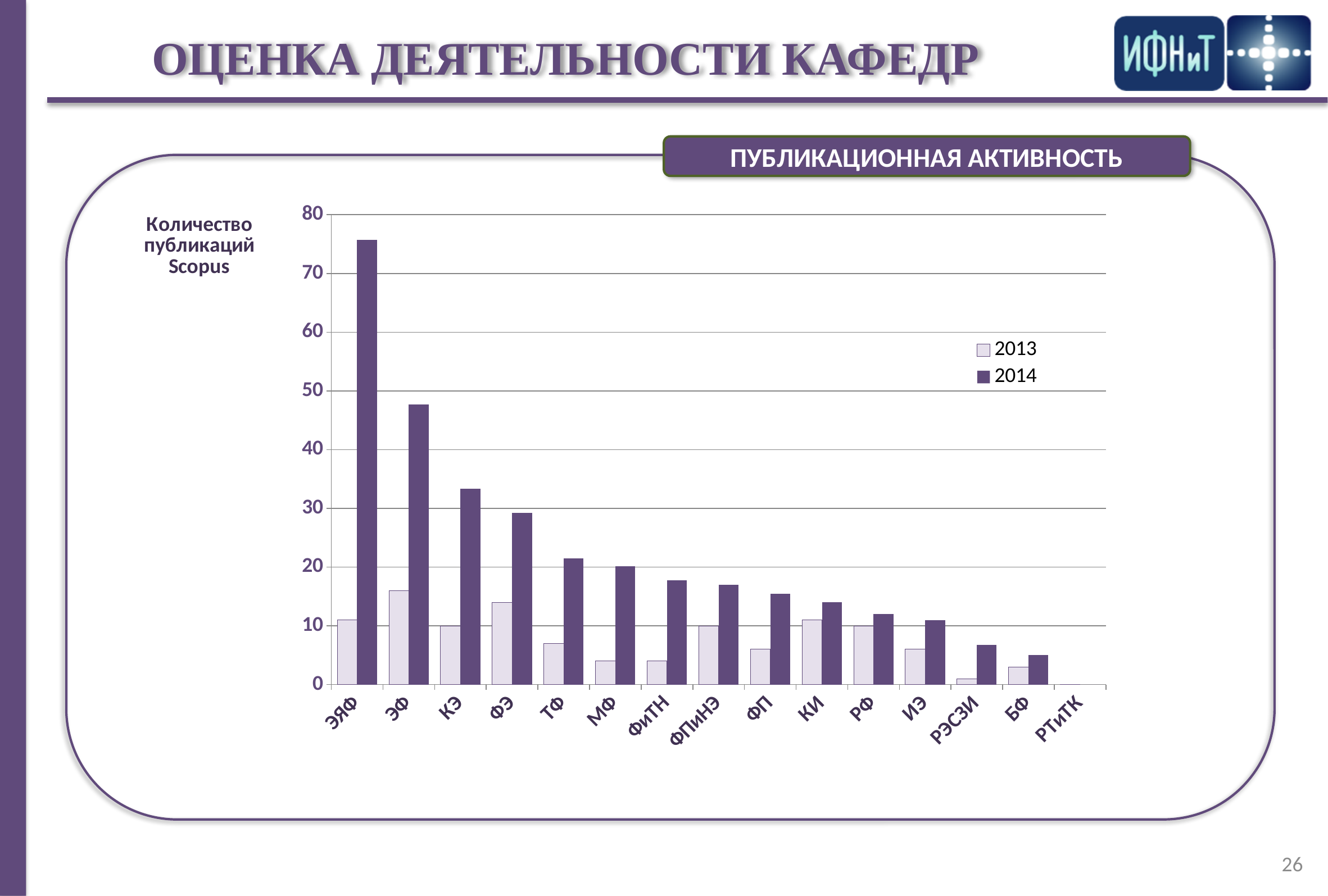
How many departments (categories) are shown on the x axis? 15 Is the 2014 value for ЭЯФ greater or less than 70? greater Is the 2014 value for БФ greater or less than 10? less Which department has the highest value for 2014? ЭЯФ Is the 2014 value for КЭ greater or less than 30? greater What are the two entries in the chart legend? 2013 and 2014 Which is larger, the 2014 value for ЭЯФ or the 2014 value for ЭФ? ЭЯФ Do the 2014 values rise or fall moving from left to right along the x axis? fall How many series does the legend list? 2 Which department has the lowest value for 2014? РТиТК What kind of chart is shown on the slide? bar chart